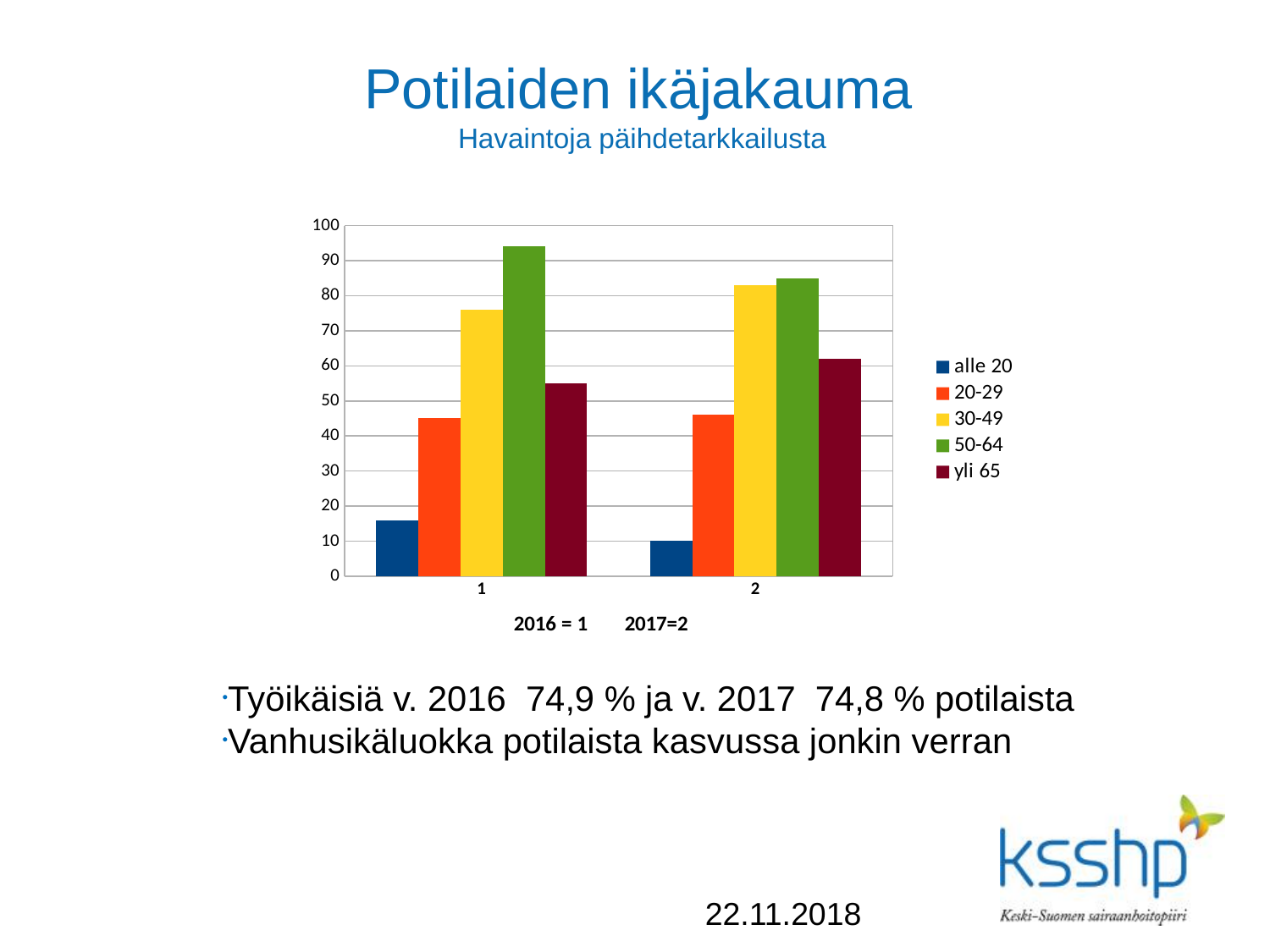
How many categories are shown on the x axis? 2 Is the value for 30-49 in category 1 greater or less than 80? less Is the value for alle 20 in category 2 greater or less than 20? less What kind of chart is shown on the slide? bar chart Which age group has the highest bar in category 1? 50-64 Which age group has the lowest bar in category 1? alle 20 Which age group has the lowest bar in category 2? alle 20 Is the value for 50-64 in category 1 greater or less than 90? greater According to the note under the x axis, which year does category 1 represent? 2016 How many series does the legend list? 5 Which is larger: the yli 65 bar in category 1 or the yli 65 bar in category 2? category 2